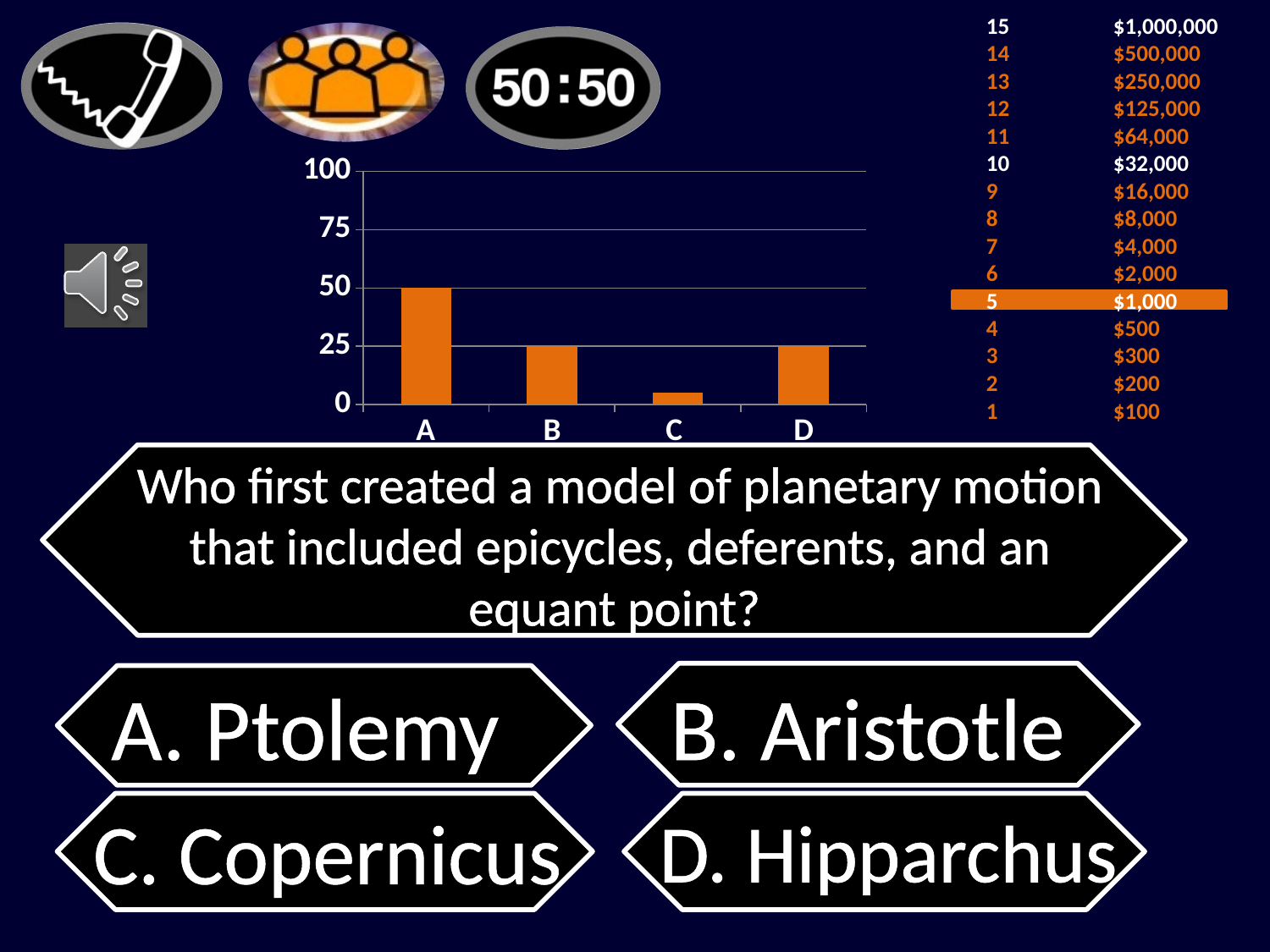
How many categories are shown on the x axis of the chart? 4 Which category has the highest bar in the chart? A Is the value for C in the chart greater or less than 25? less What colour are the bars in the chart? orange What is the value for category A in the bar chart? 50 Which is larger in the chart, the value for A or the value for C? A Is the value for A in the chart greater or less than 75? less What kind of chart is shown on the slide? bar chart Which category has the lowest bar in the chart? C What is the value for category B in the bar chart? 25 What is the value for category D in the bar chart? 25 What is the difference between the values for A and B in the chart? 25